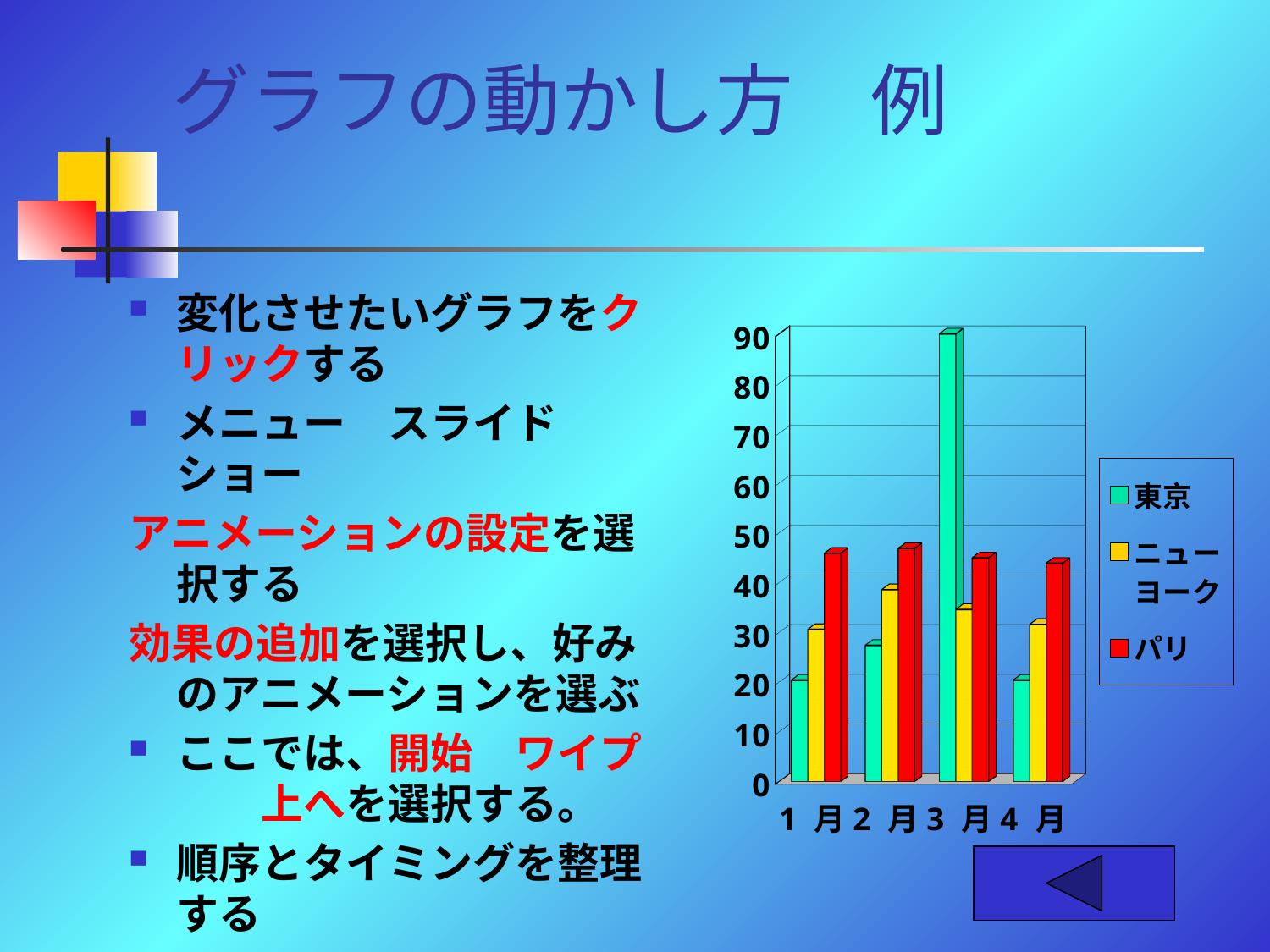
Which series is shown in red in the chart legend? パリ Which series has the lowest value in 1月? 東京 Which is larger in 2月, the value for ニューヨーク or the value for 東京? ニューヨーク How many series does the chart legend list? 3 Is the value for 東京 in 4月 greater or less than 30? less How many categories are shown on the x axis of the chart? 4 Which series has the highest value in 3月? 東京 Is the value for パリ in 1月 greater or less than 40? greater What kind of chart is shown on the slide? bar chart Is the value for 東京 in 3月 greater or less than 80? greater In which month is the value for 東京 highest? 3月 Which is larger in 4月, the value for パリ or the value for ニューヨーク? パリ